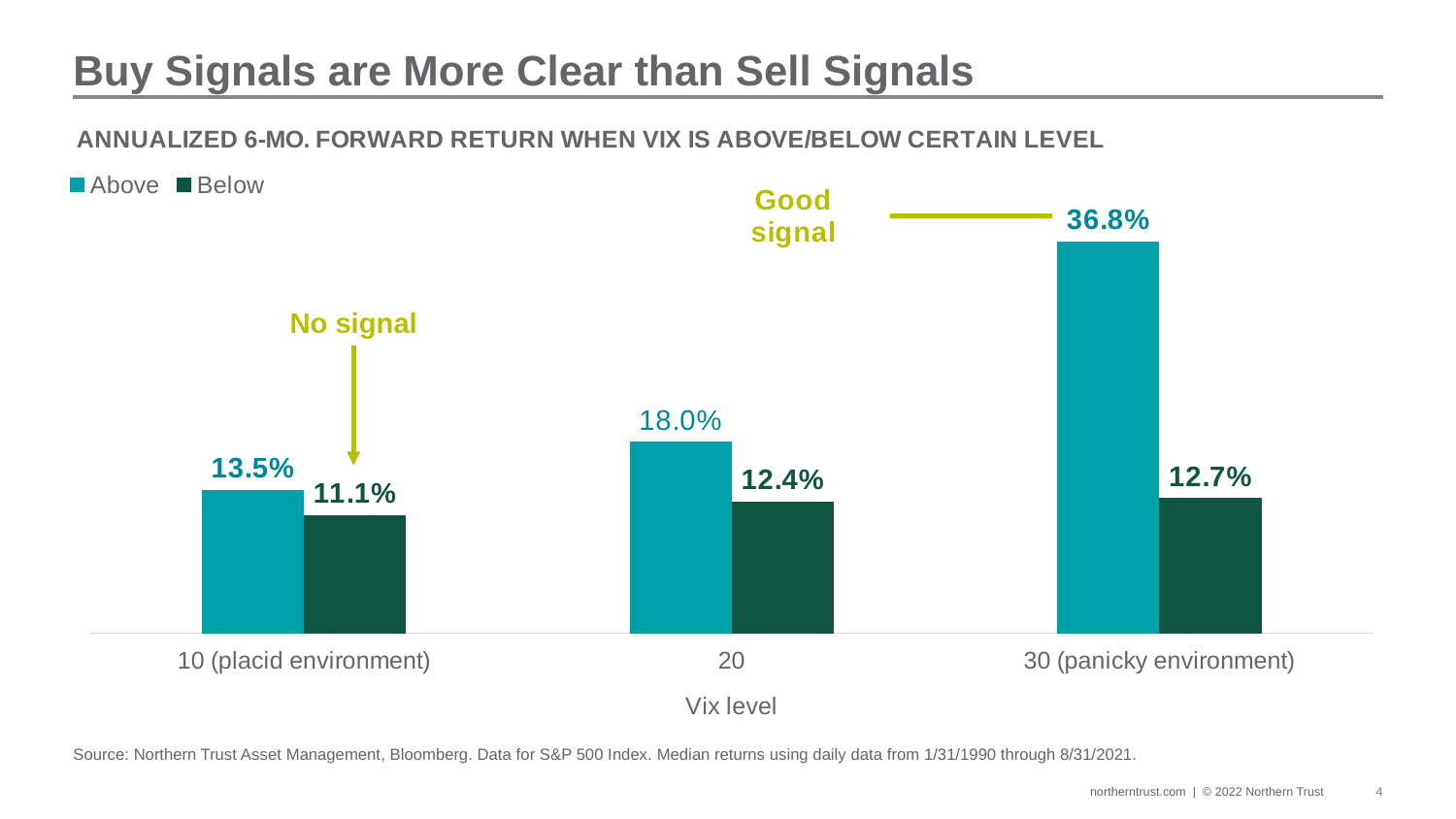
What is the 'Below' value for Vix level 30 (panicky environment)? 12.7% Which Vix level has the highest 'Above' value? 30 (panicky environment) What is the 'Above' value for Vix level 10 (placid environment)? 13.5% How many Vix level categories are shown on the chart? 3 How many series does the legend list? 2 What is the 'Below' value for Vix level 10 (placid environment)? 11.1% Which is larger at Vix level 10 (placid environment), the 'Above' value or the 'Below' value? Above Which Vix level has the lowest 'Below' value? 10 (placid environment) What is the difference between the 'Above' and 'Below' values at Vix level 30 (panicky environment)? 24.1% What is the difference between the 'Above' and 'Below' values at Vix level 20? 5.6% What is the 'Above' value for Vix level 20? 18.0% What kind of chart is shown on the slide? Bar chart